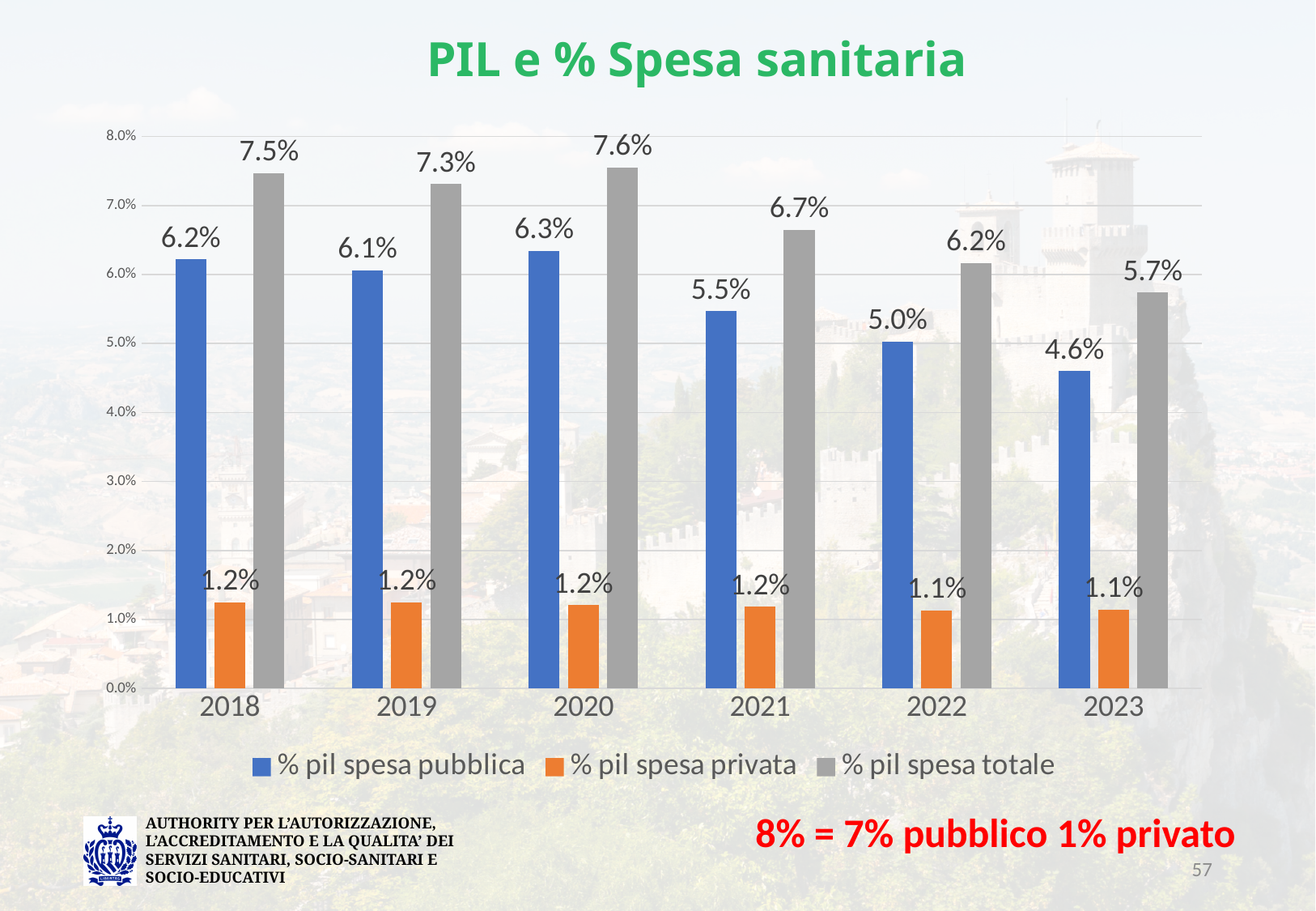
What is the value of % pil spesa privata for 2022? 1.1% Is the value of % pil spesa totale for 2021 greater or less than 7.0%? less Which year has the highest value for % pil spesa totale? 2020 Which is larger, % pil spesa pubblica in 2019 or in 2021? 2019 How many series does the legend list? 3 How many years are shown on the x axis? 6 Does % pil spesa pubblica rise or fall from 2020 to 2023? fall What is the difference between % pil spesa totale in 2018 and in 2023? 1.8% What is the value of % pil spesa totale for 2020? 7.6% Which year has the lowest value for % pil spesa pubblica? 2023 What kind of chart is shown on the slide? bar chart What is the value of % pil spesa pubblica for 2018? 6.2%